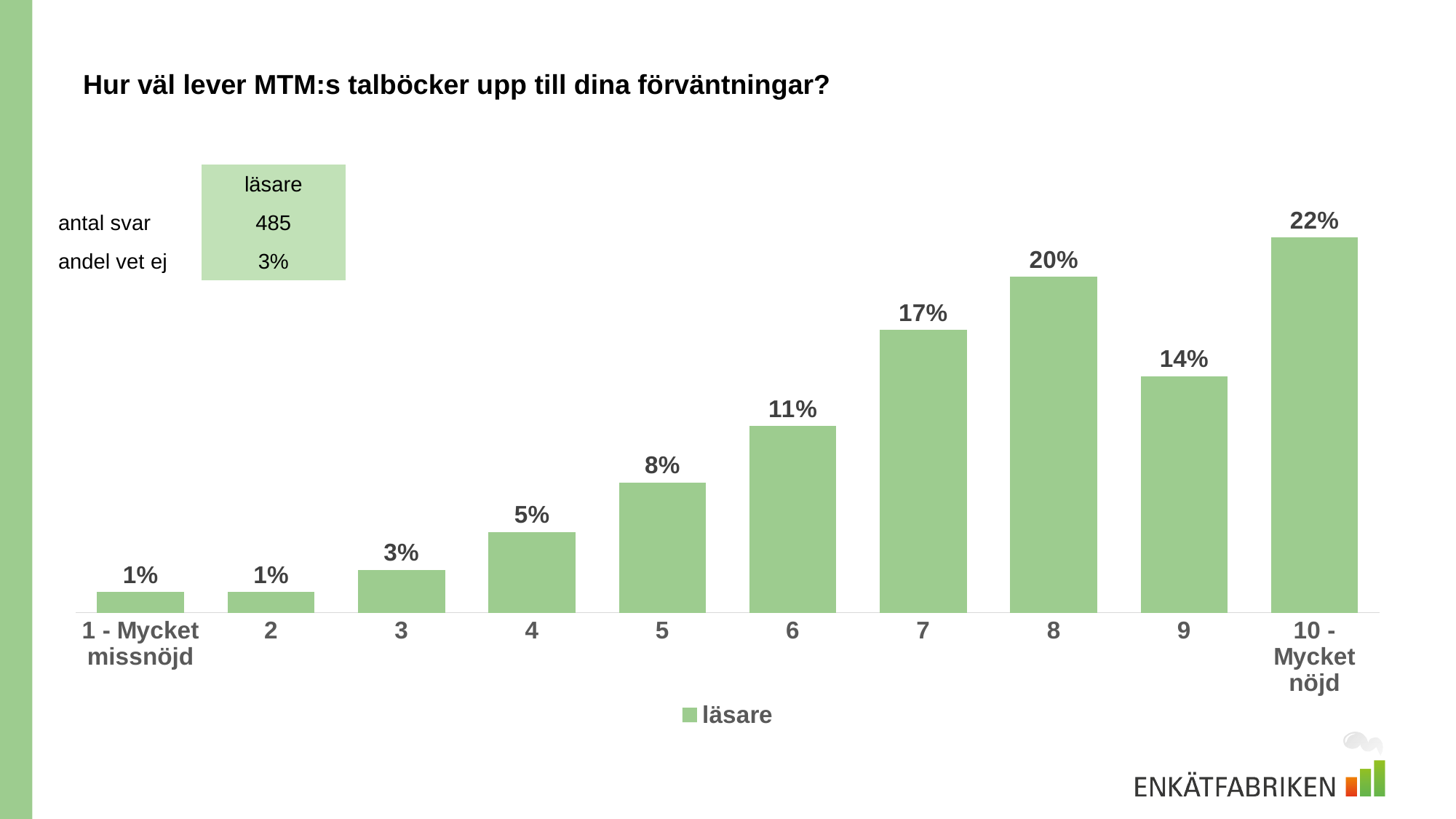
Which is larger, the value for category 7 or the value for category 9? 7 What is the name of the series in the legend? läsare How many series does the legend list? 1 What is the value for "10 - Mycket nöjd"? 22% Do the values generally rise or fall from category 1 to category 8? rise How many categories are shown on the x axis? 10 What is the value for category 5? 8% What is the title of the chart? Hur väl lever MTM:s talböcker upp till dina förväntningar? What kind of chart is shown? bar chart What is the value for category 8? 20% What is the difference between the values for category 8 and category 9? 6% Which category has the highest value? 10 - Mycket nöjd